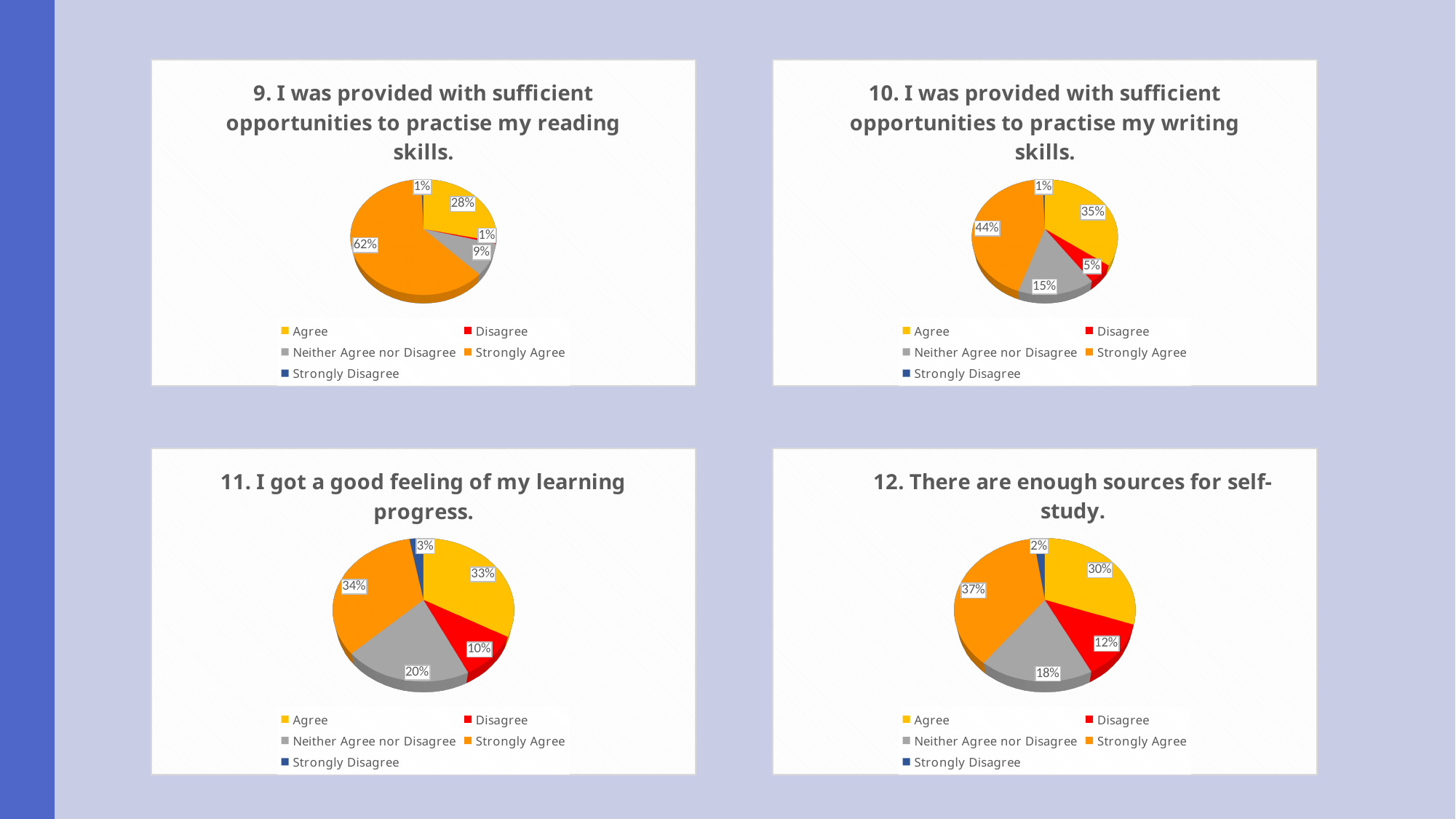
In the chart titled "12. There are enough sources for self-study.", which is larger, the Agree slice or the Strongly Agree slice? Strongly Agree In the chart titled "12. There are enough sources for self-study.", what is the difference between the Disagree and Strongly Disagree percentages? 10% How many categories does the legend list in the chart titled "11. I got a good feeling of my learning progress."? 5 In the chart titled "9. I was provided with sufficient opportunities to practise my reading skills.", what share of responses is Strongly Agree? 62% In the chart titled "11. I got a good feeling of my learning progress.", which category has the smallest slice? Strongly Disagree In the chart titled "12. There are enough sources for self-study.", what percentage is shown for Neither Agree nor Disagree? 18% What kind of chart is used in the chart titled "9. I was provided with sufficient opportunities to practise my reading skills."? Pie chart In the chart titled "10. I was provided with sufficient opportunities to practise my writing skills.", which category has the largest slice? Strongly Agree In the chart titled "9. I was provided with sufficient opportunities to practise my reading skills.", what percentage is shown for Neither Agree nor Disagree? 9% In the chart titled "10. I was provided with sufficient opportunities to practise my writing skills.", what is the difference between the Strongly Agree and Agree percentages? 9% In the chart titled "10. I was provided with sufficient opportunities to practise my writing skills.", what percentage is shown for Agree? 35% In the chart titled "11. I got a good feeling of my learning progress.", what percentage is shown for Disagree? 10%